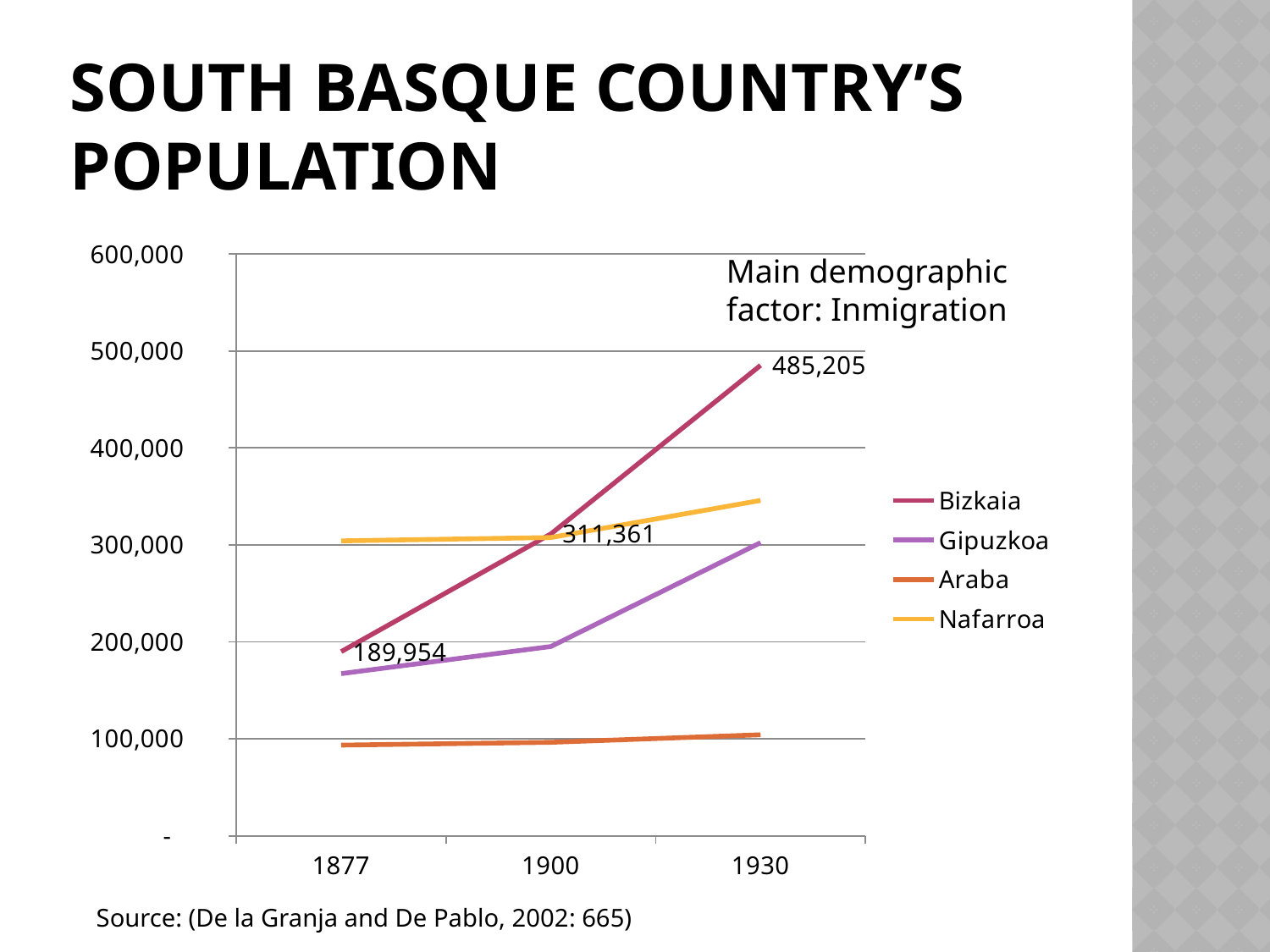
How many years are shown on the x axis? 3 By how much did Bizkaia's population grow between 1900 and 1930? 173,844 By how much did Bizkaia's population grow between 1877 and 1930? 295,251 Which region has the lowest population in 1930? Araba Which region has the highest population in 1930? Bizkaia In 1877, which had the larger population, Bizkaia or Nafarroa? Nafarroa What is the population of Bizkaia in 1930? 485,205 What is the population of Bizkaia in 1877? 189,954 What is the population of Bizkaia in 1900? 311,361 How many series does the legend list? 4 Is the value for Araba in 1930 greater or less than 200,000? less What type of chart is shown on the slide? line chart